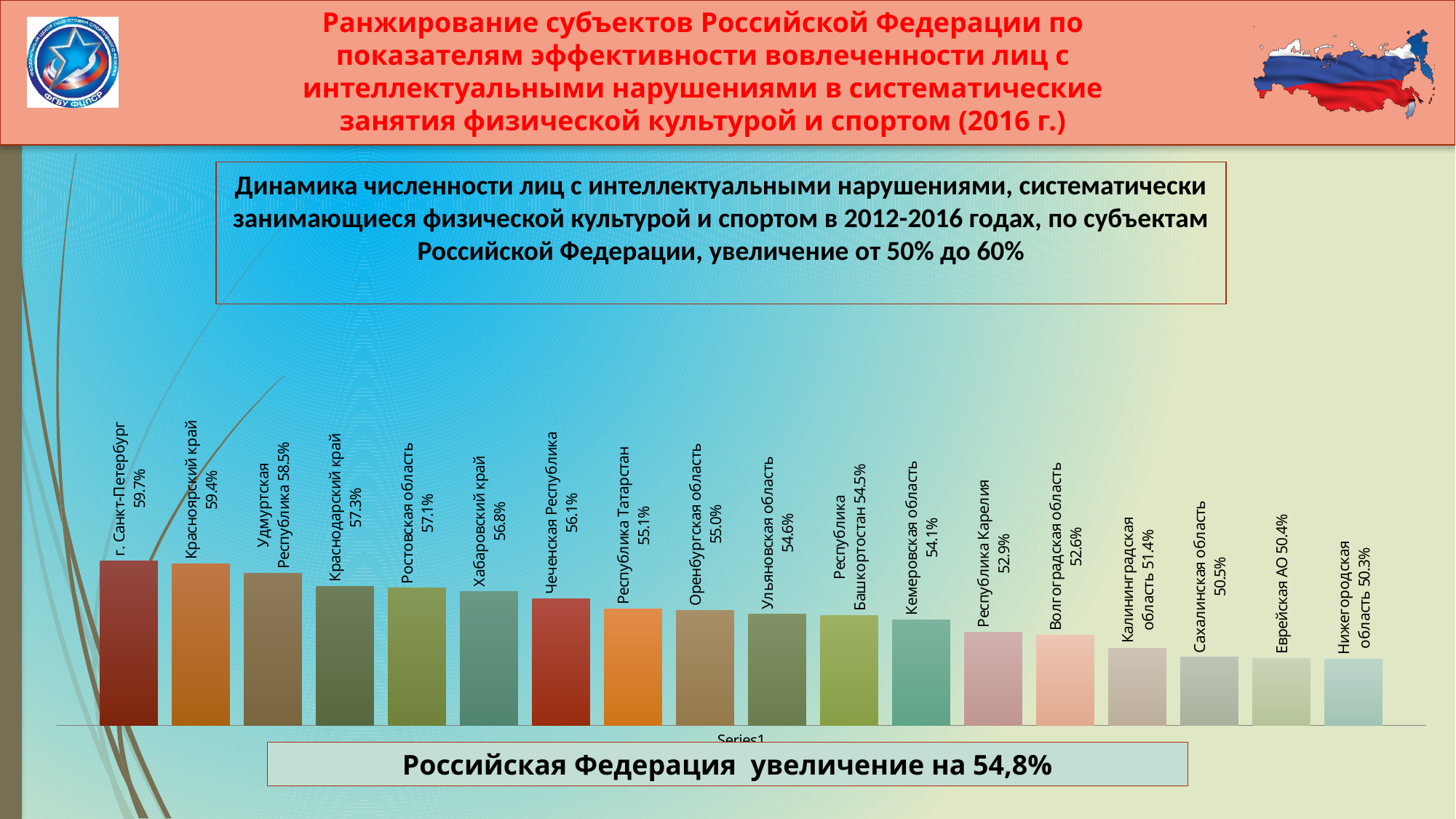
Which region has the lowest value in the chart? Нижегородская область What is the value for Хабаровский край? 56.8% What is the value for Республика Карелия? 52.9% Which has a larger value, Краснодарский край or Кемеровская область? Краснодарский край Do the values rise or fall from left to right across the chart? fall What is the value for г. Санкт-Петербург? 59.7% What is the difference between the values for г. Санкт-Петербург and Нижегородская область? 9.4% What is the difference between the values for Республика Татарстан and Волгоградская область? 2.5% Which region has the highest value in the chart? г. Санкт-Петербург What is the value for Нижегородская область? 50.3% How many regions (bars) are shown in the chart? 18 What kind of chart is shown on the slide? bar chart